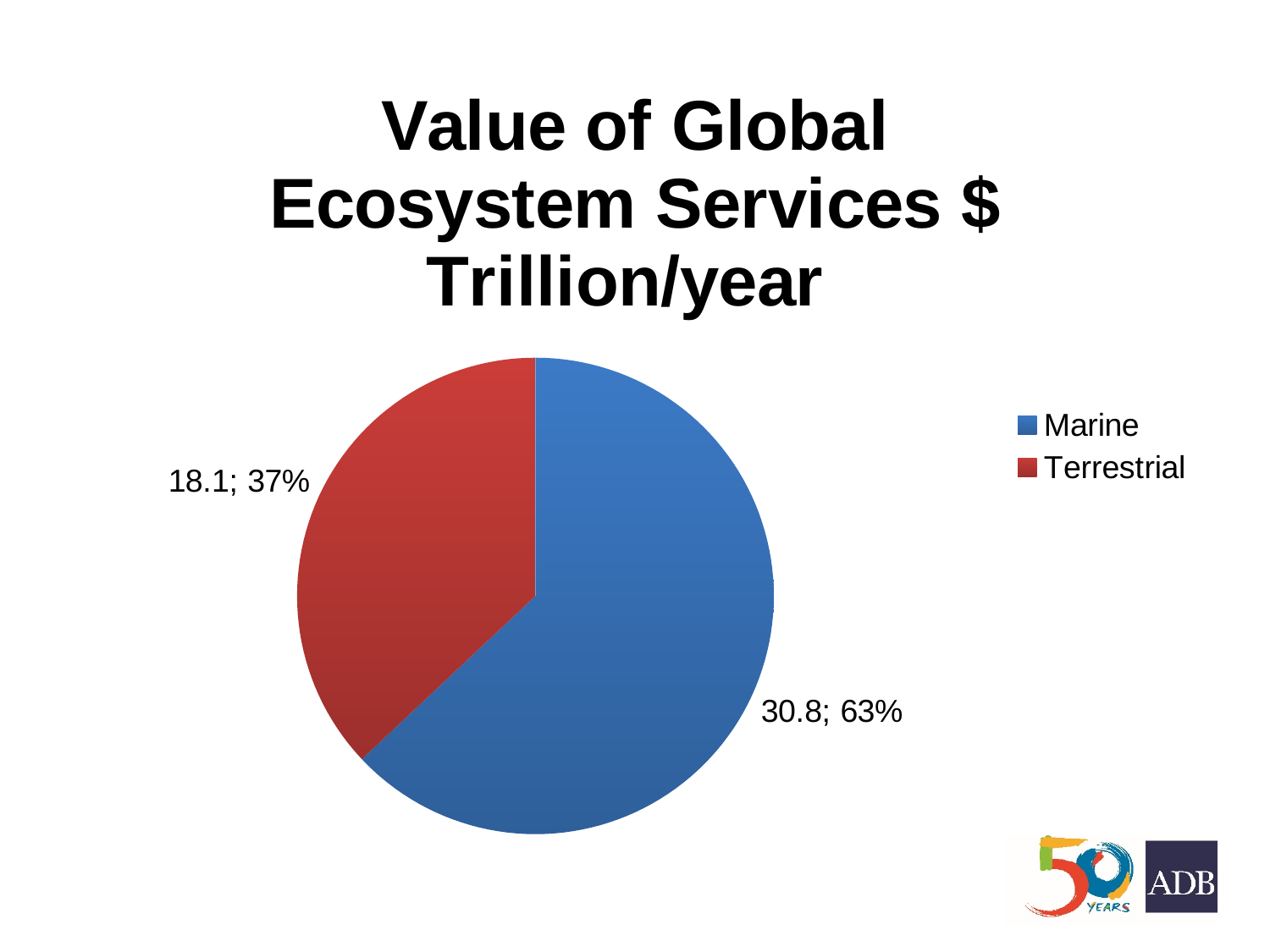
What is the value for Marine? 30.8 How many categories are shown in the pie chart? 2 What is the value for Terrestrial? 18.1 What is the title of the chart? Value of Global Ecosystem Services $ Trillion/year Which is larger, Marine or Terrestrial? Marine What colour is the Terrestrial slice? red What is the difference between the Marine and Terrestrial values? 12.7 Which category has the smallest slice? Terrestrial What share of the pie does Marine represent? 63% What share of the pie does Terrestrial represent? 37% What kind of chart is shown on the slide? pie chart Which category has the largest slice? Marine